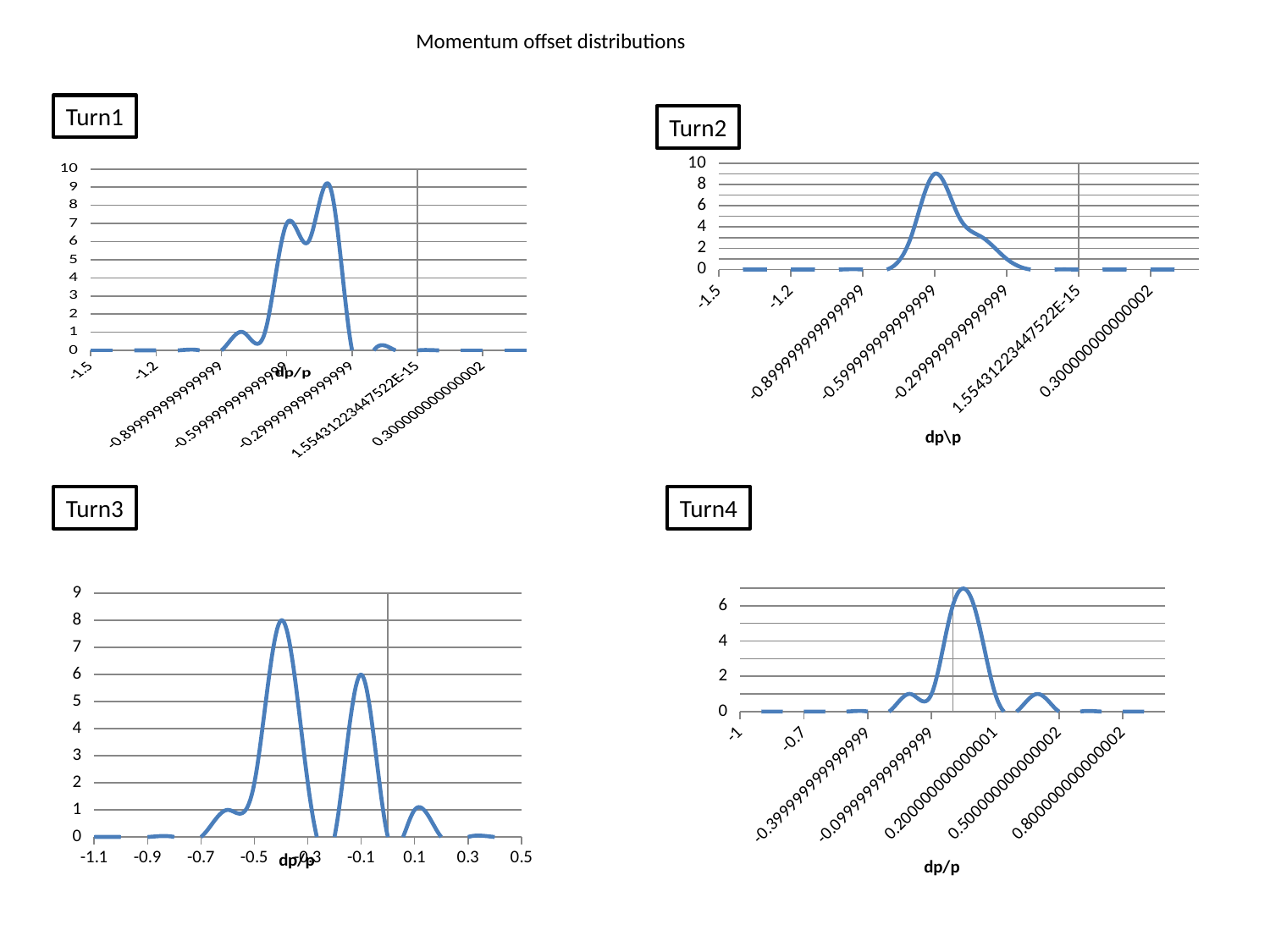
In the Turn1 chart, is the highest peak of the curve greater or less than 8? greater In the Turn3 chart, which peak is higher: the one near -0.4 or the one near -0.1? the one near -0.4 In the Turn2 chart, is the highest peak of the curve greater or less than 6? greater What is the title of the slide containing the four charts? Momentum offset distributions How many charts are shown on the slide? 4 What is the x-axis label on the Turn3 chart? dp/p In the Turn3 chart, is the peak of the curve near 0.1 greater or less than 2? less What kind of chart is the Turn1 chart? line chart What is the highest value shown on the y-axis of the Turn3 chart? 9